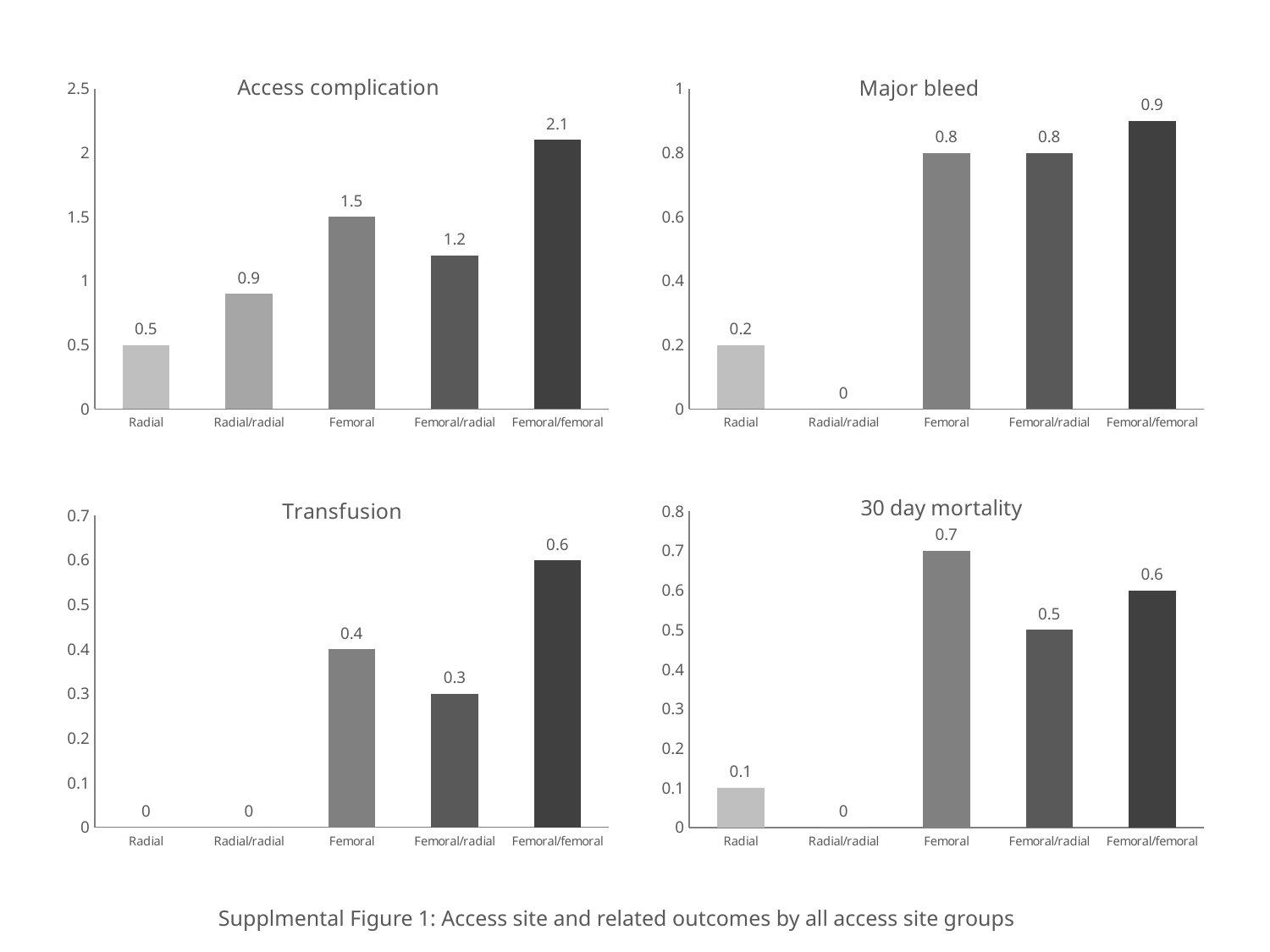
In the 30 day mortality chart, what is the difference between Femoral and Radial? 0.6 In the 30 day mortality chart, which category has the highest value? Femoral In the Transfusion chart, how many categories are shown on the x axis? 5 In the Access complication chart, what is the value for Femoral/femoral? 2.1 How many charts are shown on the slide? 4 In the Major bleed chart, what is the value for Radial/radial? 0 In the Access complication chart, which category has the lowest value? Radial What kind of chart is the Transfusion chart? Bar chart In the Major bleed chart, which category has the highest value? Femoral/femoral In the Major bleed chart, which is larger, Radial or Femoral? Femoral In the Transfusion chart, what is the value for Femoral/radial? 0.3 In the Access complication chart, what is the difference between Femoral and Femoral/radial? 0.3